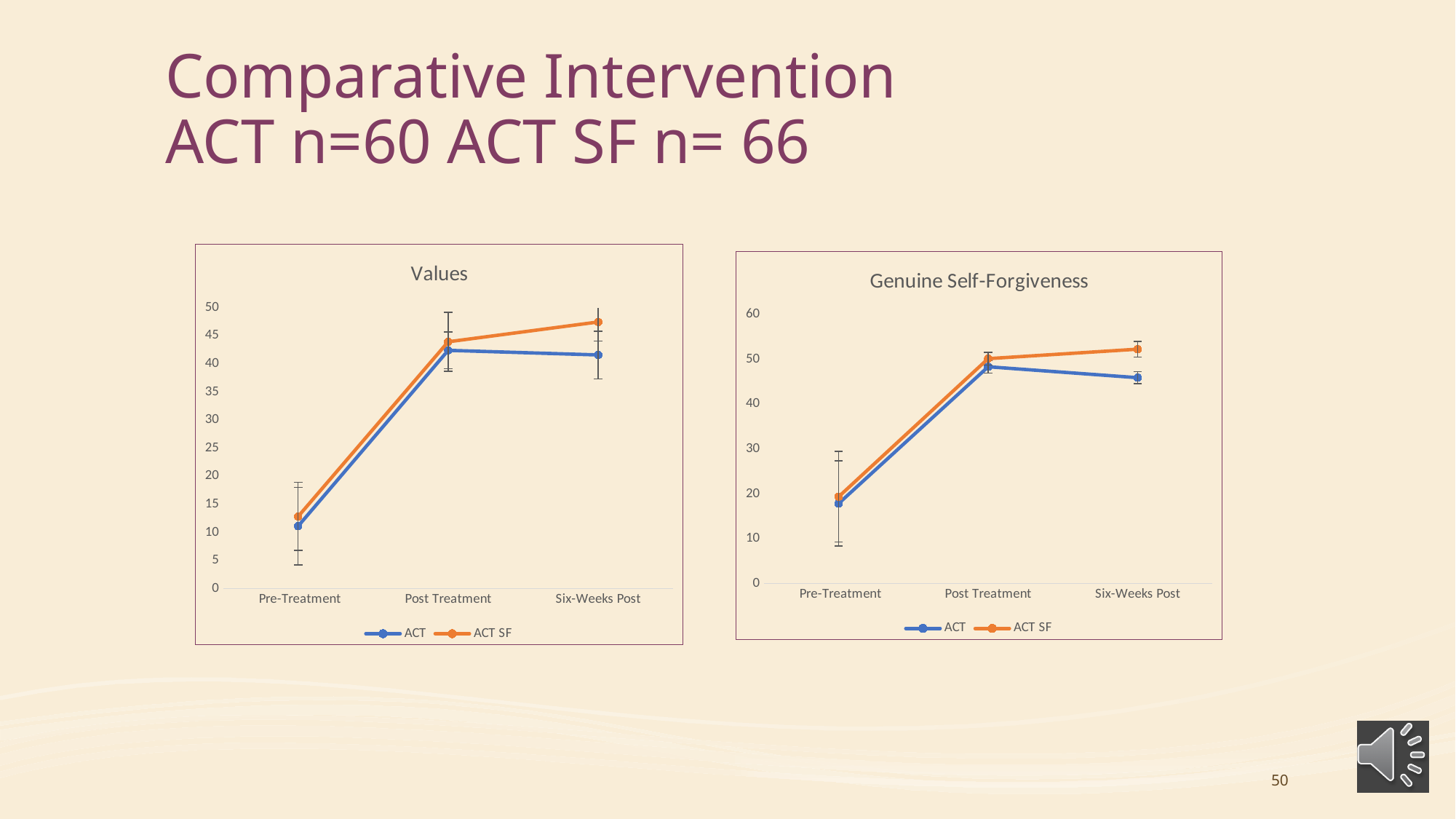
In the "Values" chart, is the ACT value at Pre-Treatment greater or less than 15? less In the "Genuine Self-Forgiveness" chart, does the ACT series rise or fall from Post Treatment to Six-Weeks Post? fall In the "Values" chart, which series has the higher value at Six-Weeks Post, ACT or ACT SF? ACT SF What colour is the ACT SF line in the "Values" chart? orange In the "Values" chart, is the ACT SF value at Six-Weeks Post greater or less than 45? greater In the "Genuine Self-Forgiveness" chart, which series has the higher value at Six-Weeks Post, ACT or ACT SF? ACT SF In the "Values" chart, does the ACT SF series rise or fall from Pre-Treatment to Post Treatment? rise How many series does the legend of the "Genuine Self-Forgiveness" chart list? 2 In the "Genuine Self-Forgiveness" chart, is the ACT SF value at Six-Weeks Post greater or less than 50? greater How many time points are shown on the x axis of the "Values" chart? 3 What kind of chart is the "Values" chart? line chart